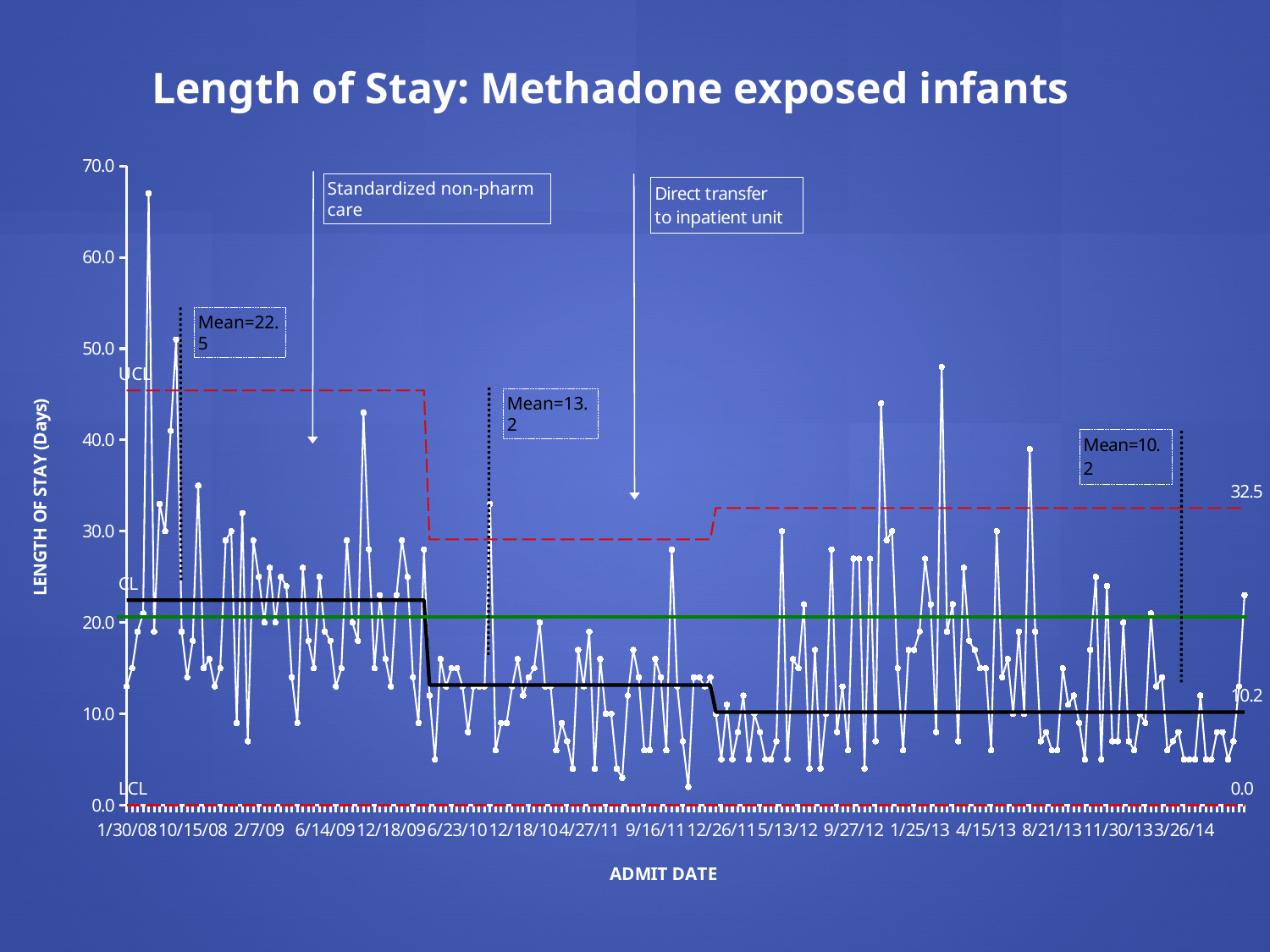
What is the mean length of stay shown for the final period of the chart? 10.2 What is the title of the chart? Length of Stay: Methadone exposed infants What is the mean length of stay shown for the second period of the chart? 13.2 What value is printed for the lower control limit (LCL) at the right end of the chart? 0.0 What kind of chart is shown on the slide? line chart What value is printed for the upper control limit (UCL) at the right end of the chart? 32.5 What is the label on the vertical axis of the chart? LENGTH OF STAY (Days) What is the difference between the first-period mean (22.5) and the final-period mean (10.2)? 12.3 Which of the three labelled means on the chart is the highest? Mean=22.5 Is the highest plotted length of stay near the start of the chart greater or less than 60.0 days? greater Do the labelled mean values rise or fall over time along the x axis? fall What is the mean length of stay shown for the first period of the chart? 22.5